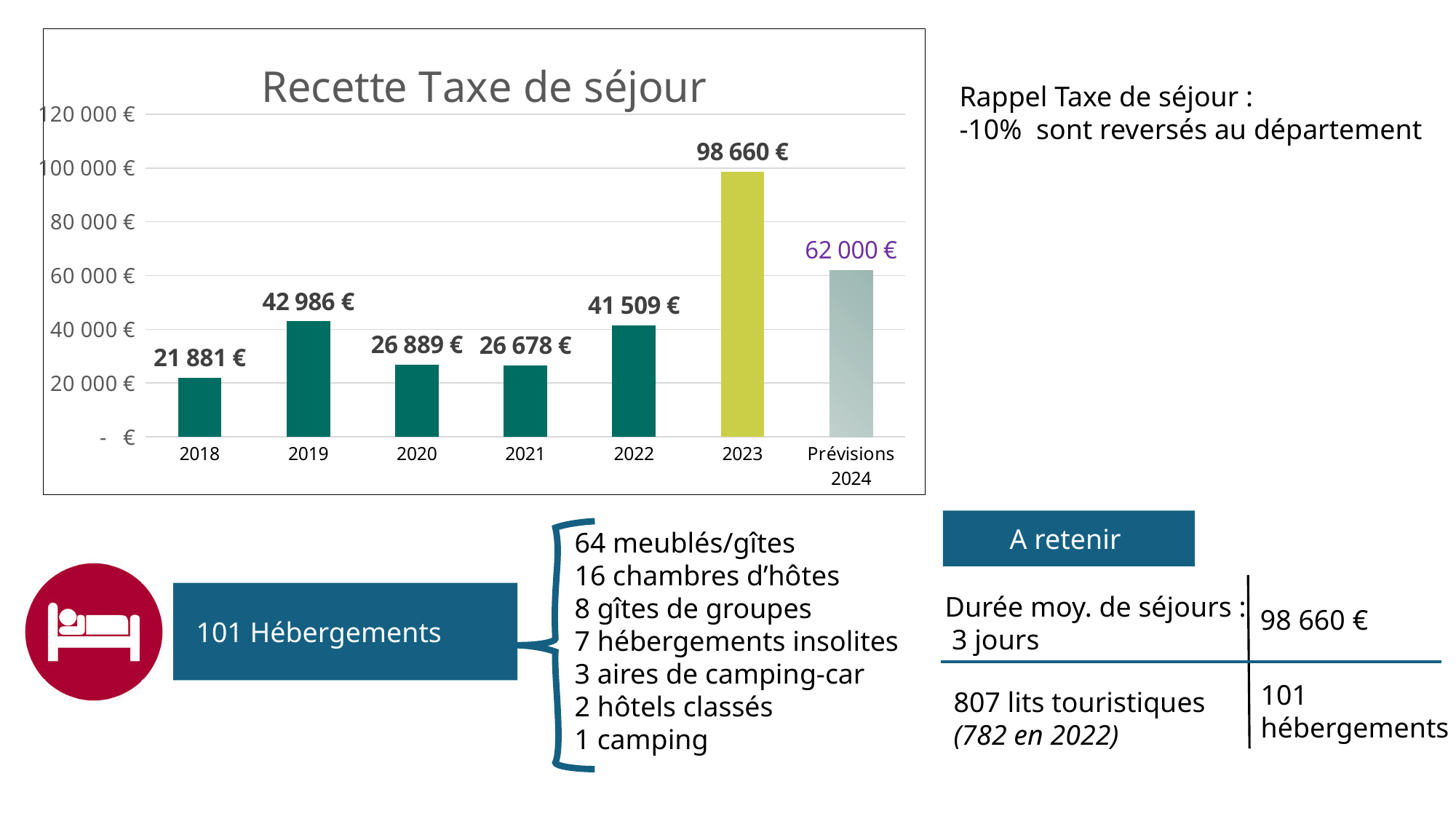
What is the value for 2023 in the Recette Taxe de séjour chart? 98 660 € Which year has the lowest Recette Taxe de séjour? 2018 What is the value for 2018 in the Recette Taxe de séjour chart? 21 881 € Which year has the highest Recette Taxe de séjour? 2023 What is the difference between the 2023 value and the 2022 value? 57 151 € What kind of chart is used to show Recette Taxe de séjour? bar chart What is the forecast value shown for Prévisions 2024? 62 000 € How many bars are shown in the Recette Taxe de séjour chart? 7 Is the value for 2023 greater or less than 80 000 €? greater What is the value for 2021 in the chart? 26 678 € Which is larger, the value for 2019 or the value for 2022? 2019 What is the difference between the 2019 value and the 2018 value? 21 105 €